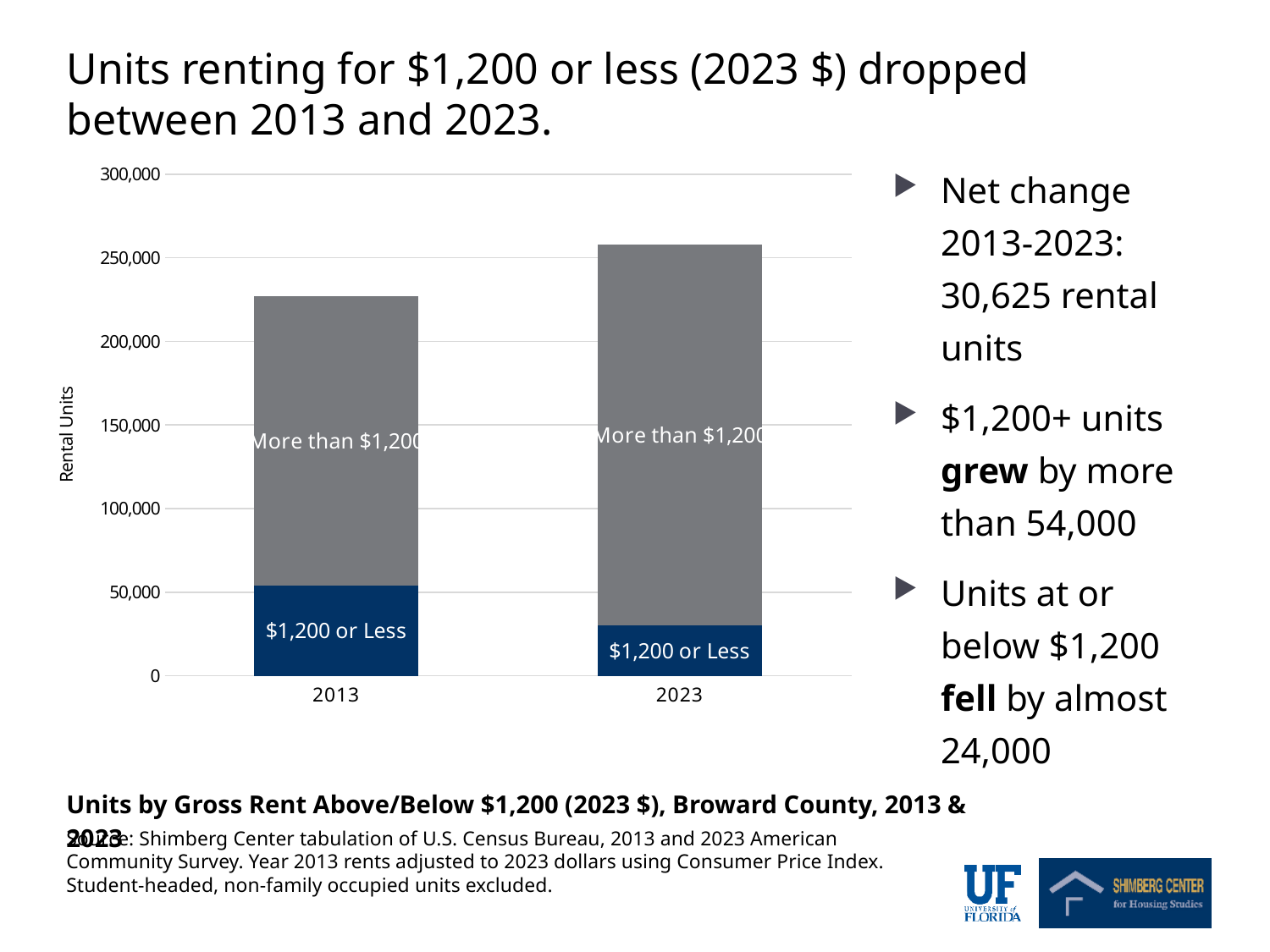
How many years (categories) are shown on the x axis of the chart? 2 Is the number of units renting for $1,200 or less in 2023 greater or less than 50,000? less In 2013, which segment is larger: '$1,200 or Less' or 'More than $1,200'? More than $1,200 What kind of chart is shown on the slide? Stacked bar chart Is the total number of rental units in 2023 greater or less than 250,000? greater How many rent segments is each bar divided into? 2 Which segment of the bars is shown in dark blue? $1,200 or Less Does the total number of rental units rise or fall from 2013 to 2023? Rise Which year has the taller total bar, 2013 or 2023? 2023 Which year has more units renting for $1,200 or less, 2013 or 2023? 2013 What is the label on the y axis of the chart? Rental Units Is the total number of rental units in 2013 greater or less than 200,000? greater